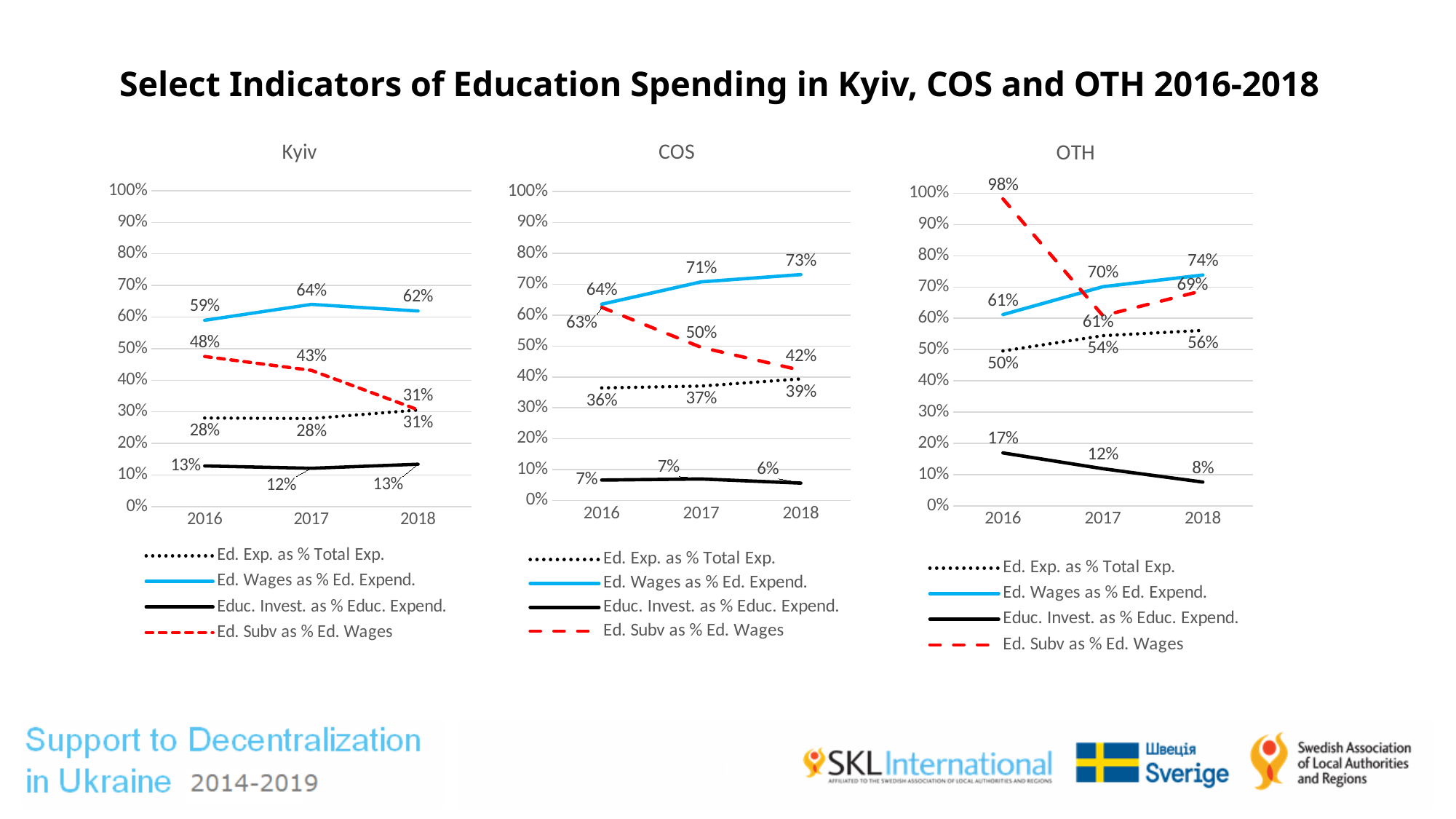
What kind of chart is the Kyiv chart? line chart In the Kyiv chart, in which year is Ed. Subv as % Ed. Wages lowest? 2018 In the COS chart, which is larger in 2017: Ed. Wages as % Ed. Expend. or Ed. Subv as % Ed. Wages? Ed. Wages as % Ed. Expend. In the Kyiv chart, what is the difference between Ed. Subv as % Ed. Wages in 2016 and 2018? 17% In the COS chart, what is the value of Ed. Subv as % Ed. Wages in 2018? 42% In the OTH chart, what is the value of Educ. Invest. as % Educ. Expend. in 2018? 8% In the COS chart, in which year is Ed. Wages as % Ed. Expend. highest? 2018 In the OTH chart, what is the difference between Ed. Wages as % Ed. Expend. in 2018 and 2016? 13% In the Kyiv chart, what is the value of Ed. Wages as % Ed. Expend. in 2017? 64% In the OTH chart, does Educ. Invest. as % Educ. Expend. rise or fall from 2016 to 2018? fall How many series does the legend of the COS chart list? 4 In the OTH chart, what is the value of Ed. Subv as % Ed. Wages in 2016? 98%